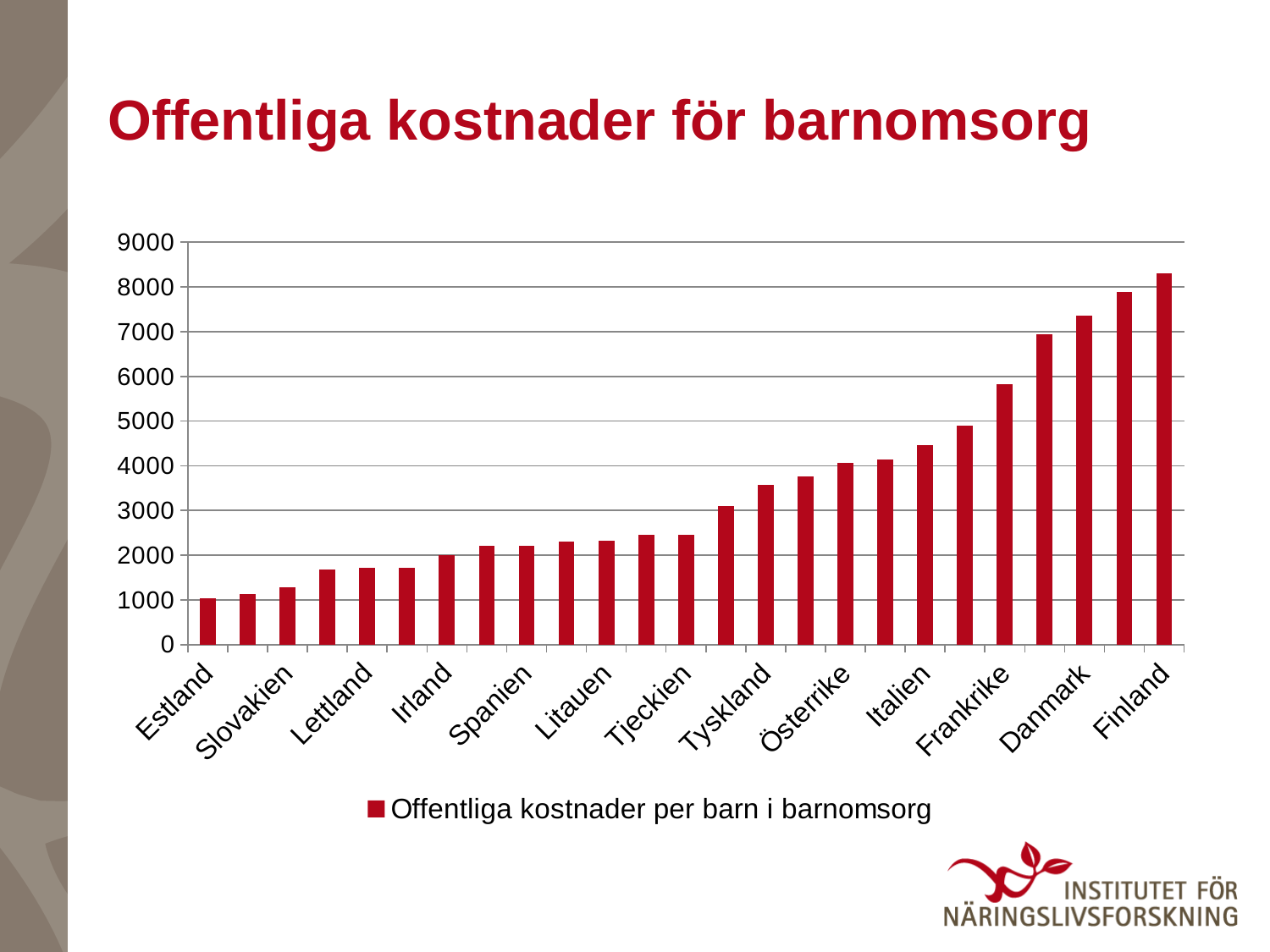
Is the value for Estland greater or less than 2000? less Do the values rise or fall from left to right along the x axis? rise Which country has the highest value for Offentliga kostnader per barn i barnomsorg? Finland How many series does the legend list? 1 Which has the larger value, Danmark or Frankrike? Danmark Is the value for Tyskland greater or less than 3000? greater Which country has the lowest value for Offentliga kostnader per barn i barnomsorg? Estland Is the value for Frankrike greater or less than 5000? greater What is the title of the chart on the slide? Offentliga kostnader för barnomsorg What kind of chart is shown on the slide? bar chart